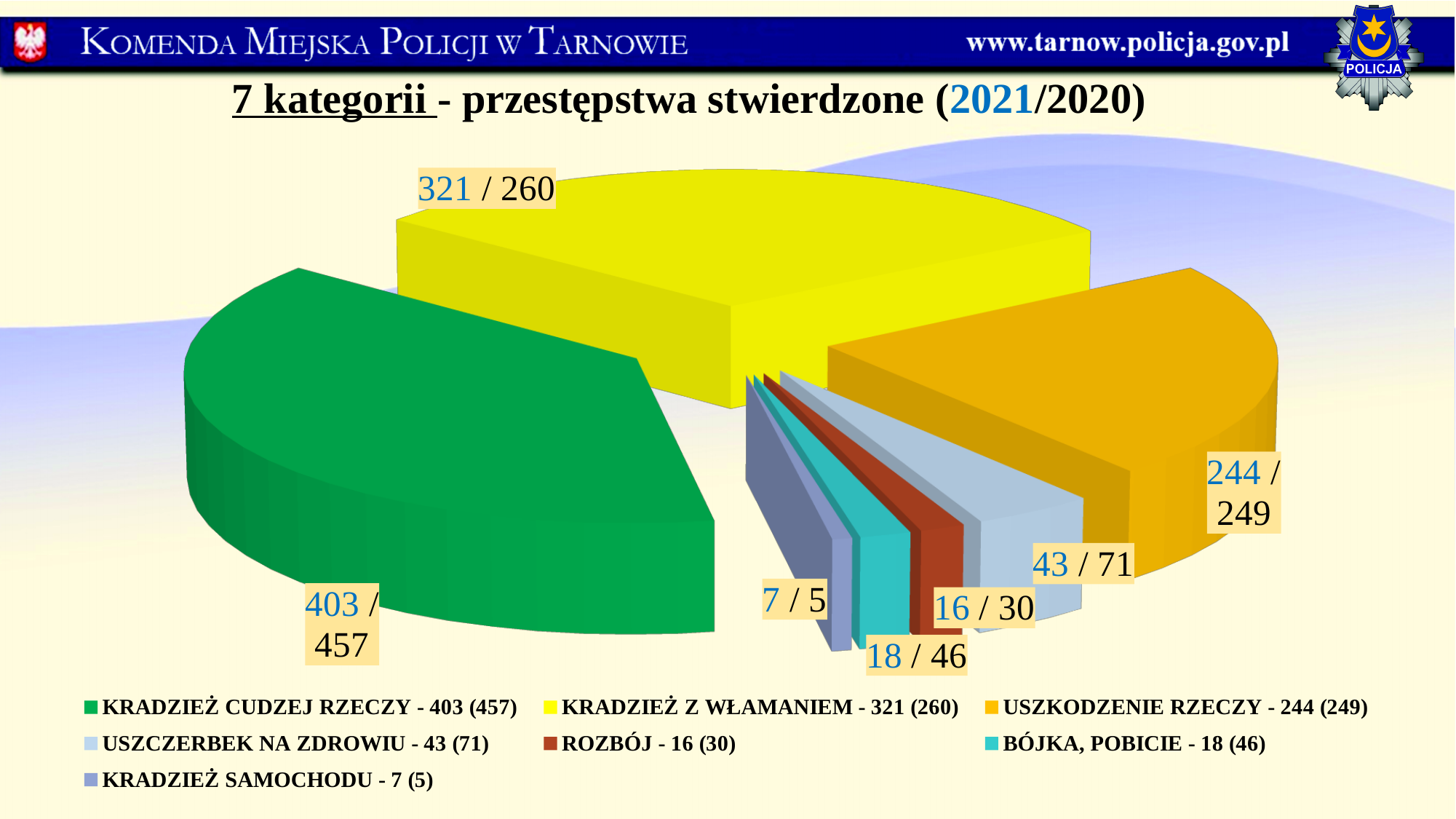
Which category has the highest 2021 value? KRADZIEŻ CUDZEJ RZECZY Which has the larger 2021 value, ROZBÓJ or BÓJKA, POBICIE? BÓJKA, POBICIE What is the 2021 value for KRADZIEŻ SAMOCHODU? 7 What is the 2020 value (in parentheses) for USZCZERBEK NA ZDROWIU? 71 What is the 2021 value for KRADZIEŻ Z WŁAMANIEM? 321 What type of chart is shown on the slide? pie chart By how much did KRADZIEŻ Z WŁAMANIEM change from 2020 (260) to 2021 (321)? 61 Which category has the lowest 2021 value? KRADZIEŻ SAMOCHODU Which colour represents USZKODZENIE RZECZY in the pie chart? orange What is the title of the slide's chart? 7 kategorii - przestępstwa stwierdzone (2021/2020) How many categories does the pie chart show? 7 What is the difference between the 2021 values for KRADZIEŻ CUDZEJ RZECZY and KRADZIEŻ Z WŁAMANIEM? 82